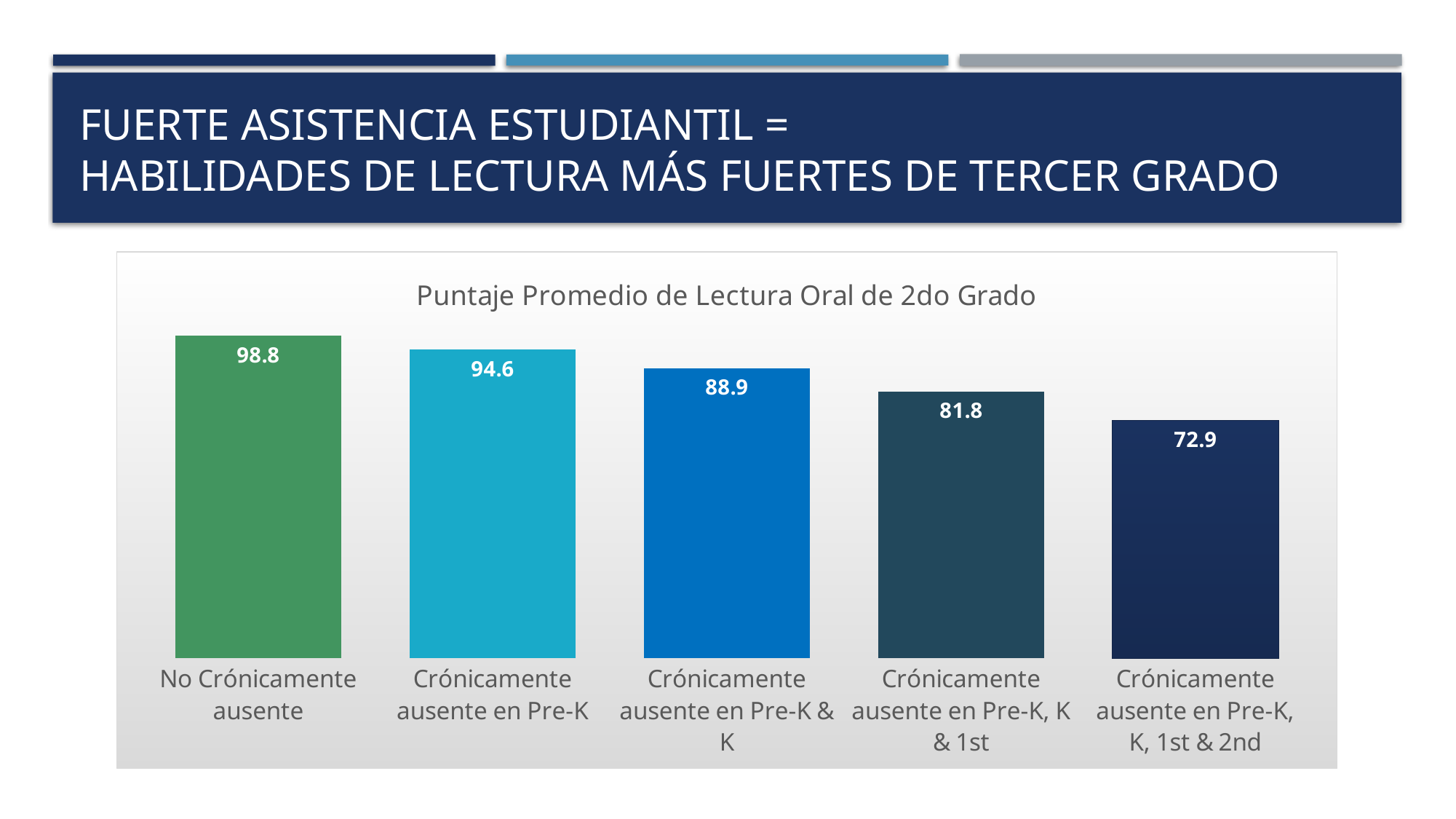
What is the value for "Crónicamente ausente en Pre-K, K & 1st"? 81.8 What is the value for "Crónicamente ausente en Pre-K, K, 1st & 2nd"? 72.9 What kind of chart is shown on the slide? Bar chart What is the value for "No Crónicamente ausente"? 98.8 Which category has the lowest value? Crónicamente ausente en Pre-K, K, 1st & 2nd How many categories are shown in the chart? 5 What is the difference between the values for "No Crónicamente ausente" and "Crónicamente ausente en Pre-K, K, 1st & 2nd"? 25.9 What is the value for "Crónicamente ausente en Pre-K"? 94.6 Which is larger, the value for "Crónicamente ausente en Pre-K" or for "Crónicamente ausente en Pre-K & K"? Crónicamente ausente en Pre-K Which category has the highest value? No Crónicamente ausente What is the value for "Crónicamente ausente en Pre-K & K"? 88.9 What is the title of the chart? Puntaje Promedio de Lectura Oral de 2do Grado